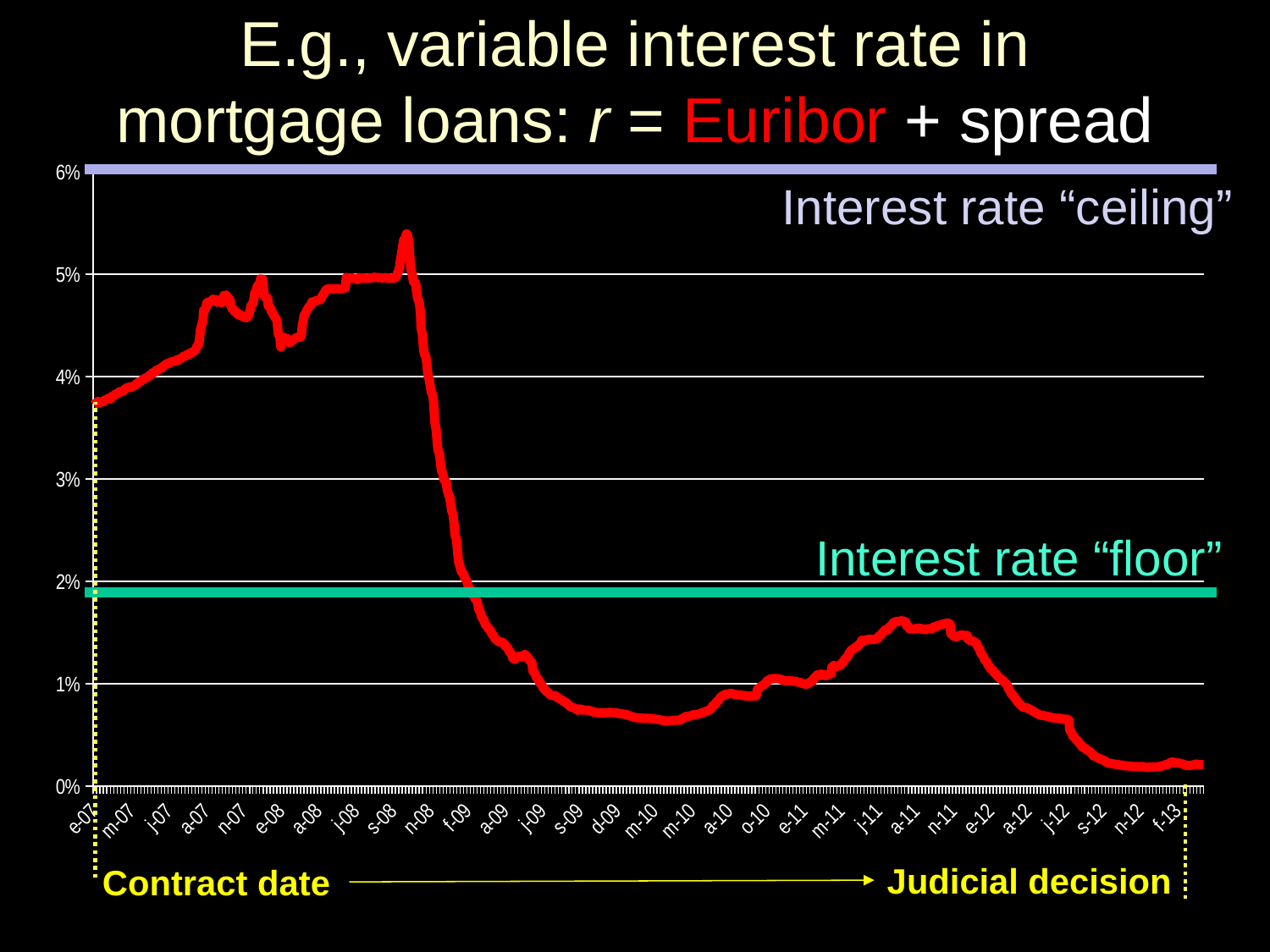
What kind of chart is shown on the slide? line chart Does the red line rise or fall overall between e-07 and s-08? rise Does the red line rise or fall between s-08 and f-09? fall Is the value of the red line at a-11 greater or less than 2%? less Is the highest point of the red line reached before or after f-09? before What is the label of the green horizontal line near 2%? Interest rate "floor" Is the highest point of the red line greater or less than 5%? greater What is the label of the horizontal line at the top of the chart? Interest rate "ceiling" Is the value of the red line at d-09 greater or less than 1%? less Which is larger, the value of the red line at e-07 or at f-13? e-07